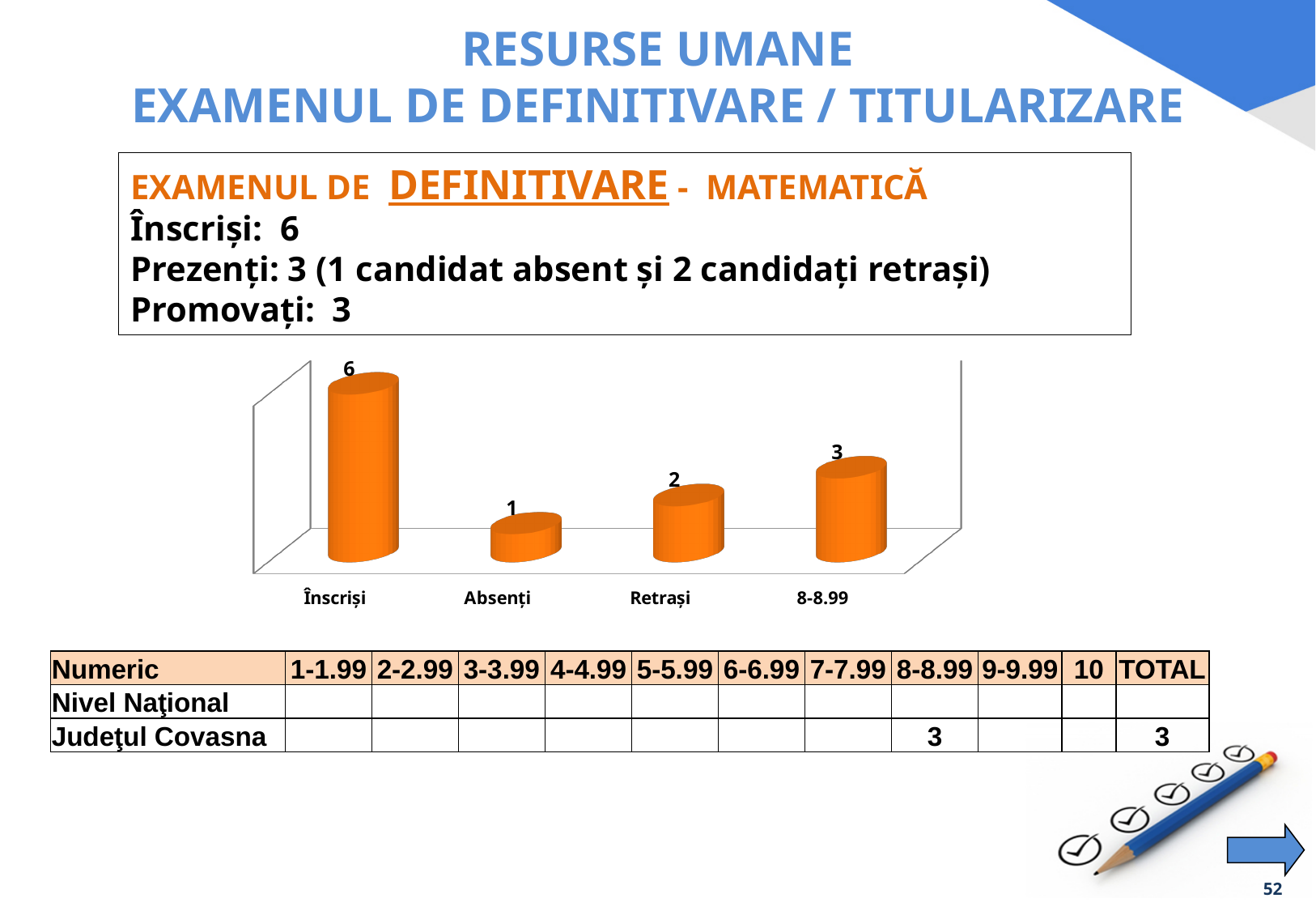
What is the value for Retrași in the chart? 2 How many categories are shown in the chart? 4 What is the value for the 8-8.99 category in the chart? 3 What is the difference between the values for Înscriși and 8-8.99? 3 What is the value for Absenți in the chart? 1 What colour are the bars in the chart? orange Which is larger, the value for Retrași or the value for 8-8.99? 8-8.99 What kind of chart is shown on the slide? bar chart Which category has the lowest value in the chart? Absenți What is the difference between the values for Retrași and Absenți? 1 Which category has the highest value in the chart? Înscriși What is the value for Înscriși in the chart? 6